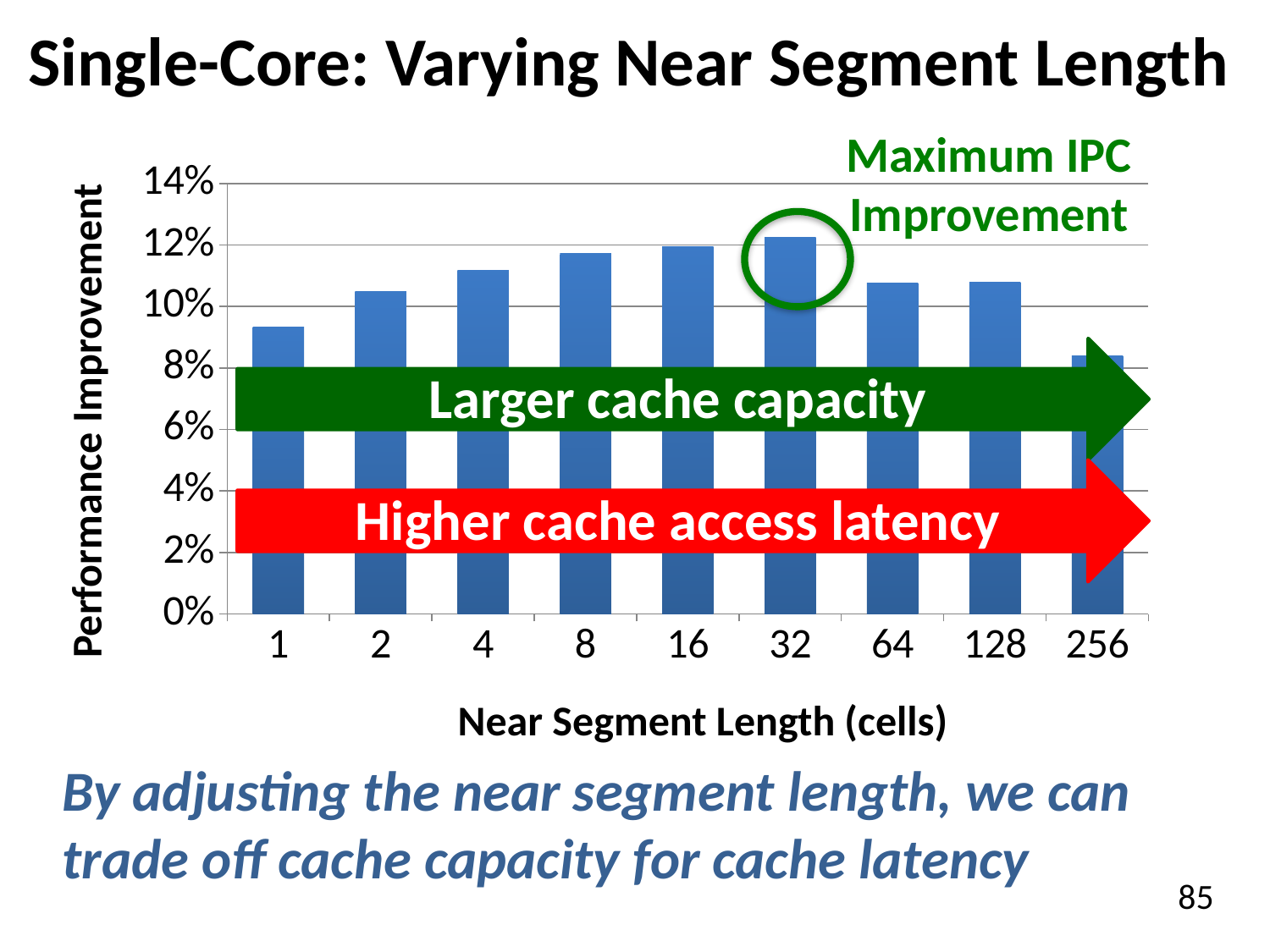
How does performance improvement change as near segment length increases from 1 to 256? rises up to 32, then falls Which near segment length has the lowest performance improvement? 256 What is the title of the x axis? Near Segment Length (cells) How many near segment lengths are plotted on the x axis? 9 Which has the larger performance improvement: a near segment length of 16 or 64? 16 Is the performance improvement for a near segment length of 1 greater or less than 8%? greater What kind of chart is shown on the slide? bar chart Is the performance improvement for a near segment length of 256 greater or less than 10%? less Which has the larger performance improvement: a near segment length of 2 or 8? 8 Is the performance improvement for a near segment length of 64 greater or less than 12%? less Which near segment length has the highest performance improvement? 32